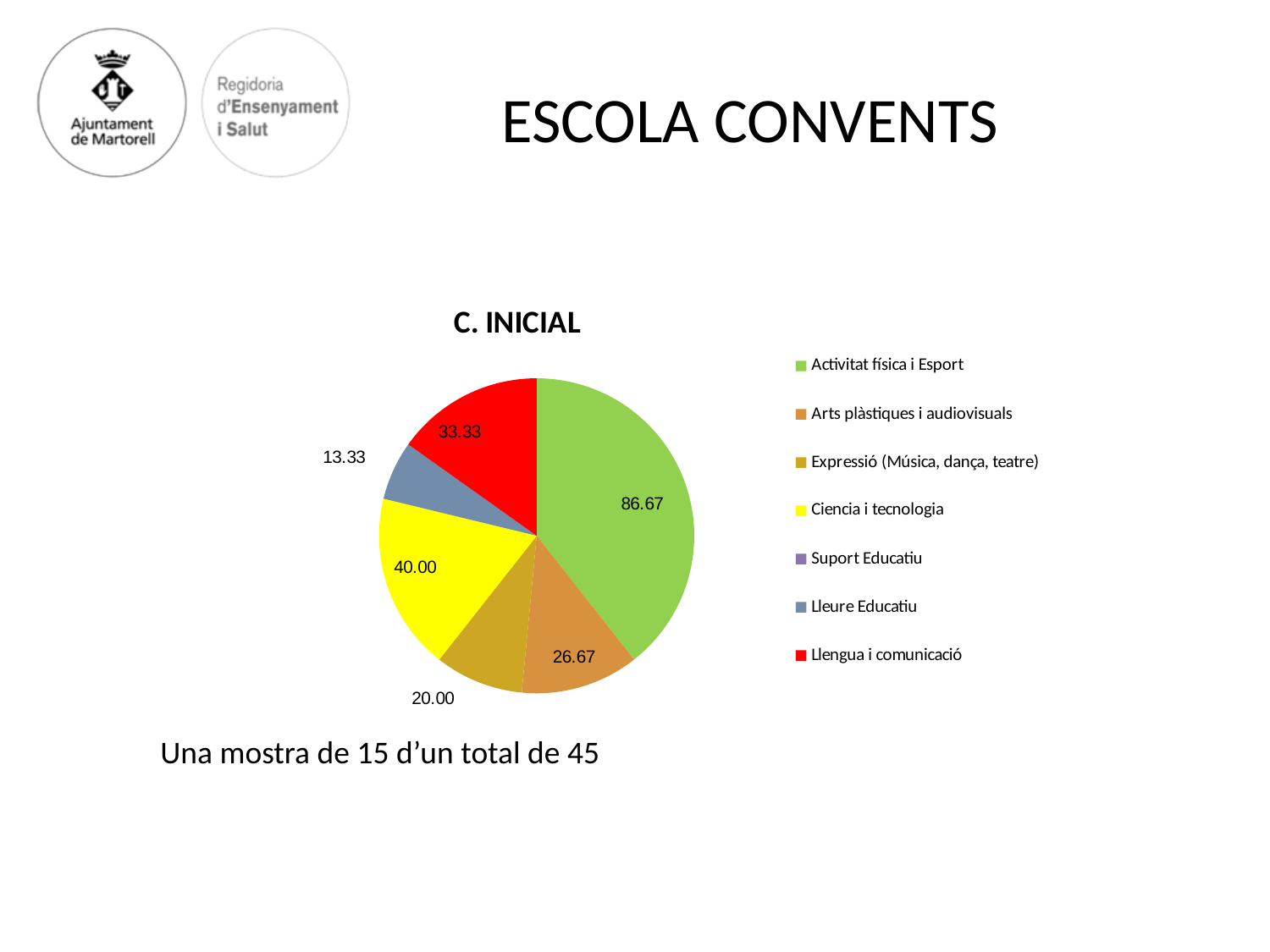
What is the difference between the values for Activitat física i Esport and Ciencia i tecnologia? 46.67 Which is larger, the value for Llengua i comunicació or the value for Arts plàstiques i audiovisuals? Llengua i comunicació What value is shown for Arts plàstiques i audiovisuals? 26.67 Which category has the largest slice in the pie chart? Activitat física i Esport What is the title of the chart? C. INICIAL What is the value shown for Activitat física i Esport in the C. INICIAL pie chart? 86.67 What is the value for Expressió (Música, dança, teatre)? 20.00 What kind of chart is shown on the slide? Pie chart How many categories does the legend list? 7 Among the labelled slices, which category has the smallest value? Lleure Educatiu What is the value for Llengua i comunicació? 33.33 What value is labelled on the Ciencia i tecnologia slice? 40.00